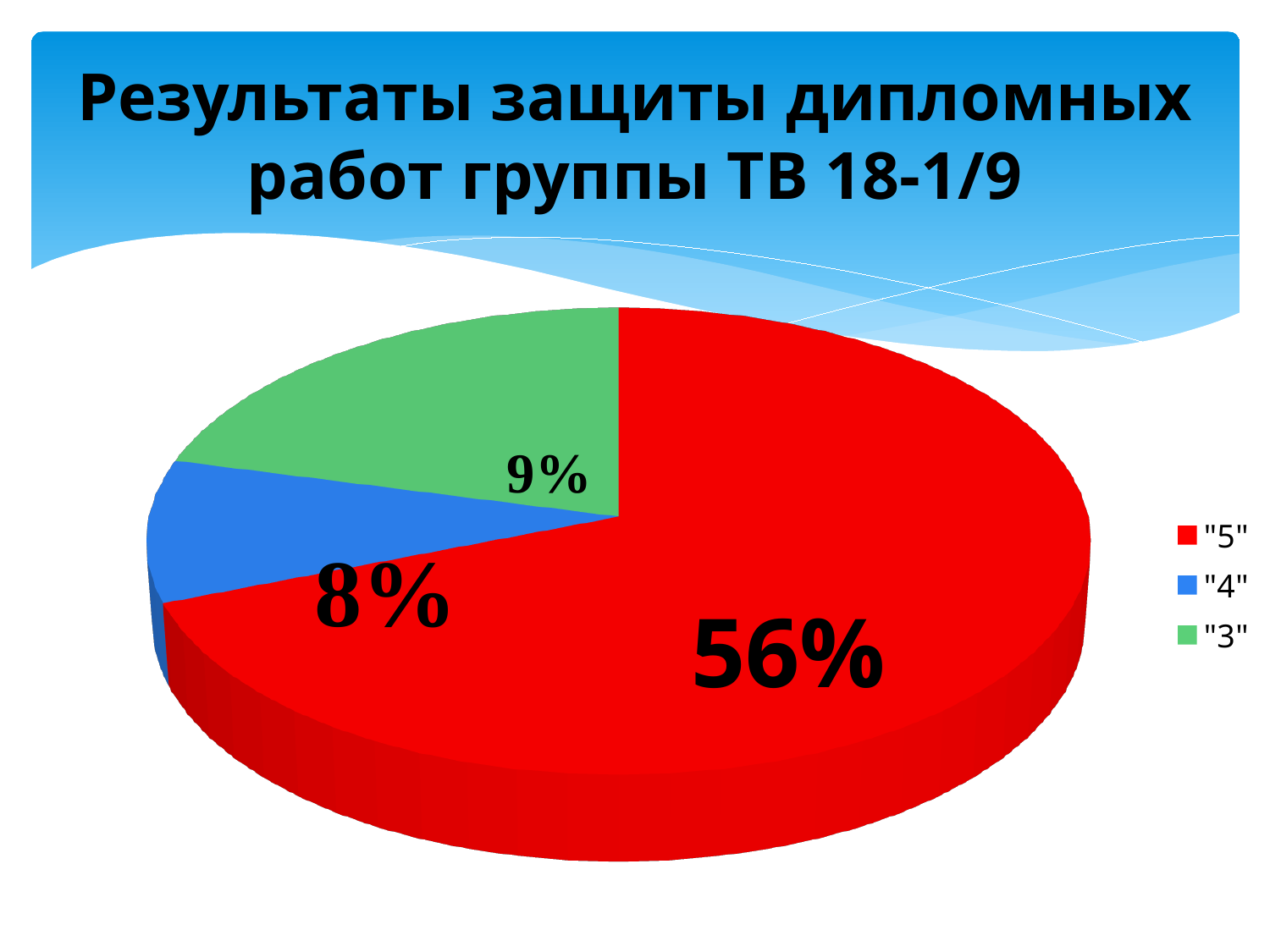
What percentage is shown for the "3" slice? 9% Which colour represents the "3" grade in the chart? green What is the title of the slide containing the chart? Результаты защиты дипломных работ группы ТВ 18-1/9 How many entries does the legend list? 3 Which grade has the smallest share of the pie? "4" What percentage is shown for the "5" slice? 56% How many slices does the pie chart have? 3 What type of chart is shown on the slide? pie chart What percentage is shown for the "4" slice? 8% What is the difference between the "5" share and the "4" share? 48% What is the difference between the "5" share and the "3" share? 47% Which grade has the largest share of the pie? "5"